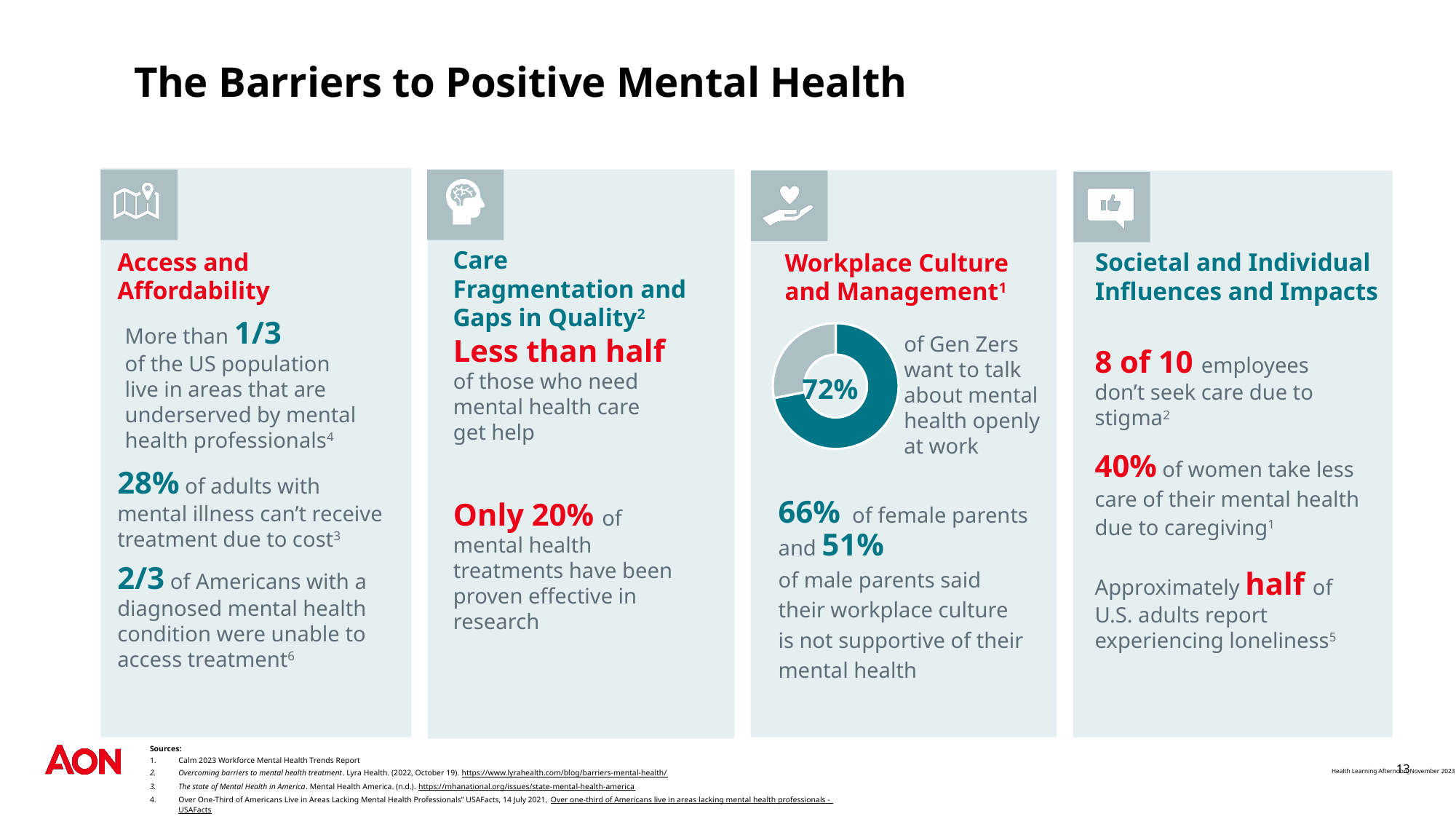
What percentage is printed in the centre of the donut chart? 72% Which slice of the donut chart is larger, the dark teal slice or the grey slice? The dark teal slice According to the donut chart, what share of Gen Zers want to talk about mental health openly at work? 72% How many slices does the donut chart have? 2 Is the value shown in the donut chart greater or less than 50%? greater What kind of chart is shown in the Workplace Culture and Management column? Donut (pie) chart Under which heading on the slide does the donut chart appear? Workplace Culture and Management Which group does the donut chart's 72% figure refer to? Gen Zers